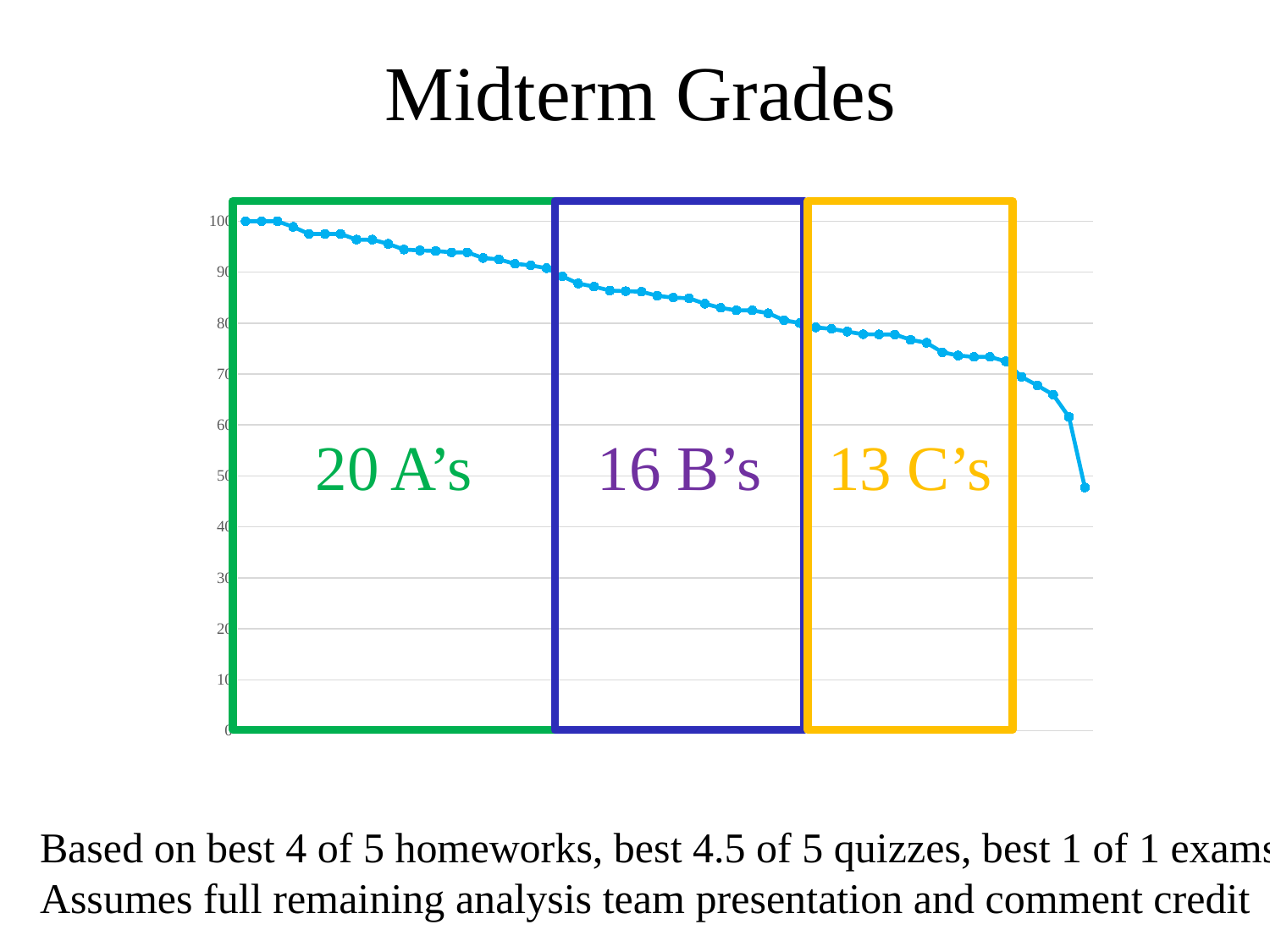
Is the value of the first (leftmost) point greater or less than 90? greater Is the value of the first (leftmost) point greater or less than 80? greater Do the plotted values rise or fall from left to right along the x axis? fall Is the value of the last (rightmost) point greater or less than 60? less According to the green box on the chart, how many A's were given? 20 What kind of chart is shown on the slide? line chart According to the yellow box on the chart, how many C's were given? 13 According to the blue box on the chart, how many B's were given? 16